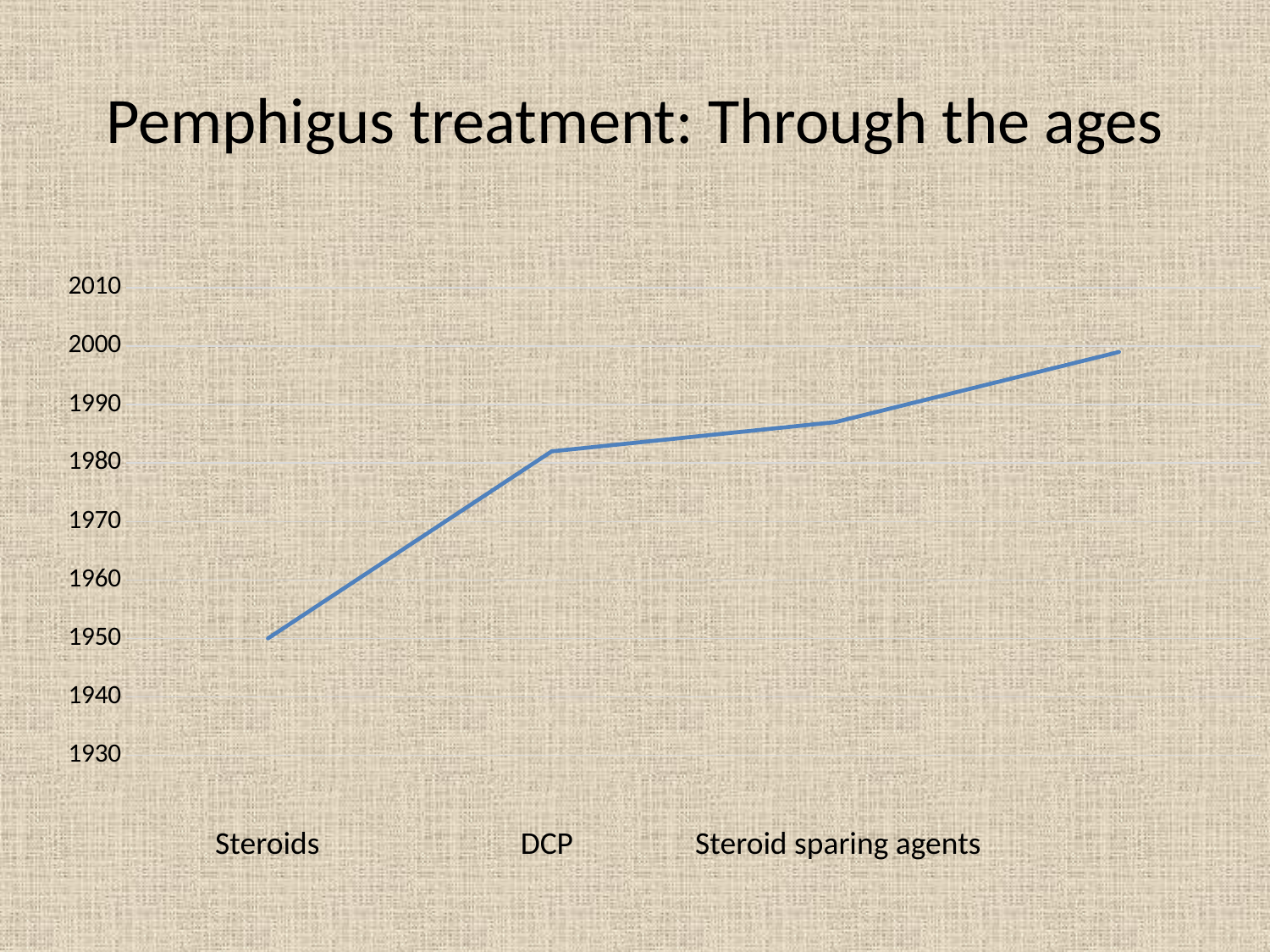
Is the value for Steroid sparing agents greater or less than 1980? greater Which has the larger value, DCP or Steroid sparing agents? Steroid sparing agents Which labeled category has the lowest value on the line? Steroids Is the value for DCP greater or less than 1990? less How many category labels are shown on the x axis? 3 Do the values rise or fall moving left to right along the x axis? rise Is the value for Steroid sparing agents greater or less than 1990? less What is the title of the chart? Pemphigus treatment: Through the ages Which has the larger value, Steroids or DCP? DCP What kind of chart is shown on the slide? line chart What year does the line show for Steroids? 1950